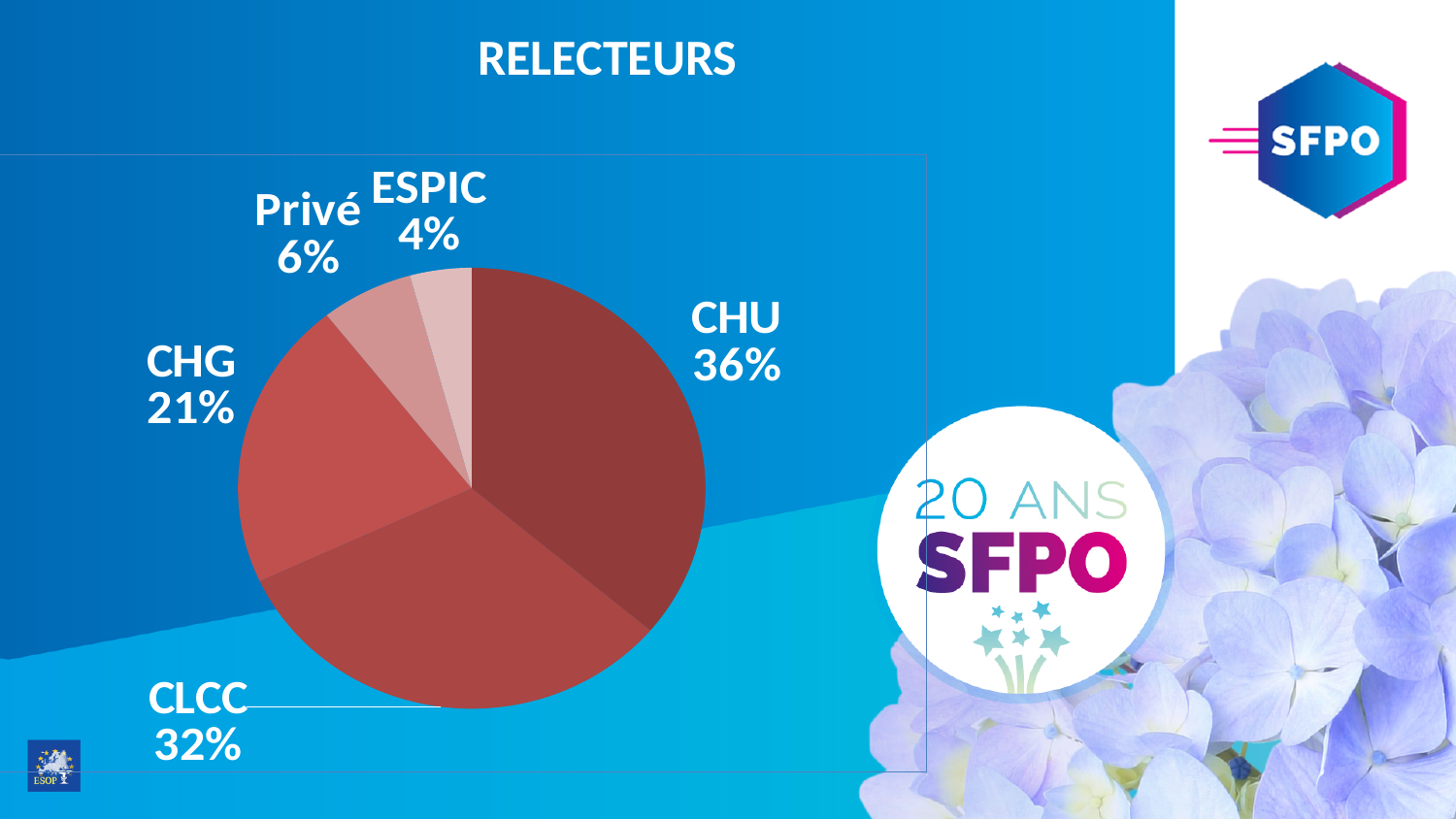
What kind of chart is shown on the slide? pie chart Which category has the smallest slice of the pie? ESPIC What is the value shown for CLCC? 32% What share of the pie does CHU represent? 36% Which is larger, the share for CHG or the share for Privé? CHG What is the difference between the CHU and CLCC shares? 4% What is the value shown for CHG? 21% Which category has the largest slice of the pie? CHU What is the value shown for ESPIC? 4% What is the value shown for Privé? 6% What is the title of the chart? RELECTEURS How many categories are shown in the pie chart? 5